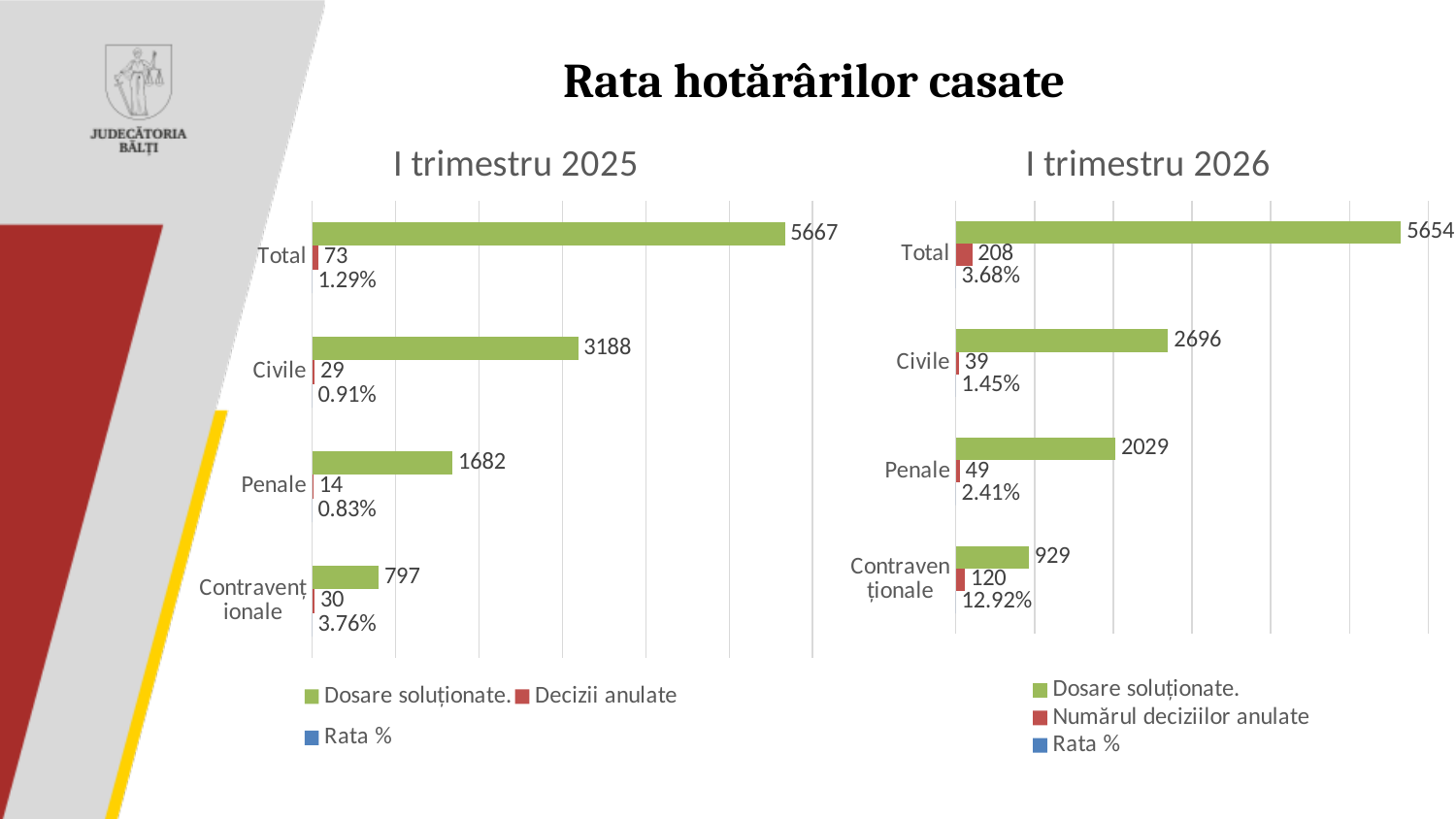
In the 'I trimestru 2025' chart, what is the value of Dosare soluționate for Civile? 3188 In the 'I trimestru 2026' chart, what is the difference between Dosare soluționate for Civile and for Penale? 667 In the 'I trimestru 2026' chart, what is the Rata % for Total? 3.68% How many series does the legend of the 'I trimestru 2026' chart list? 3 Is the value of Decizii anulate for Total larger in the 'I trimestru 2025' chart or in the 'I trimestru 2026' chart? I trimestru 2026 How many categories are shown on the y axis of the 'I trimestru 2025' chart? 4 In the 'I trimestru 2025' chart, what is the Rata % for Penale? 0.83% What type of chart is the 'I trimestru 2025' chart? Bar chart What is the difference between the Total Dosare soluționate in the 'I trimestru 2025' chart and in the 'I trimestru 2026' chart? 13 In the 'I trimestru 2025' chart, which category other than Total has the lowest value of Dosare soluționate? Contravenționale In the 'I trimestru 2026' chart, which category has the highest Rata %? Contravenționale In the 'I trimestru 2026' chart, what is the value of Numărul deciziilor anulate for Contravenționale? 120